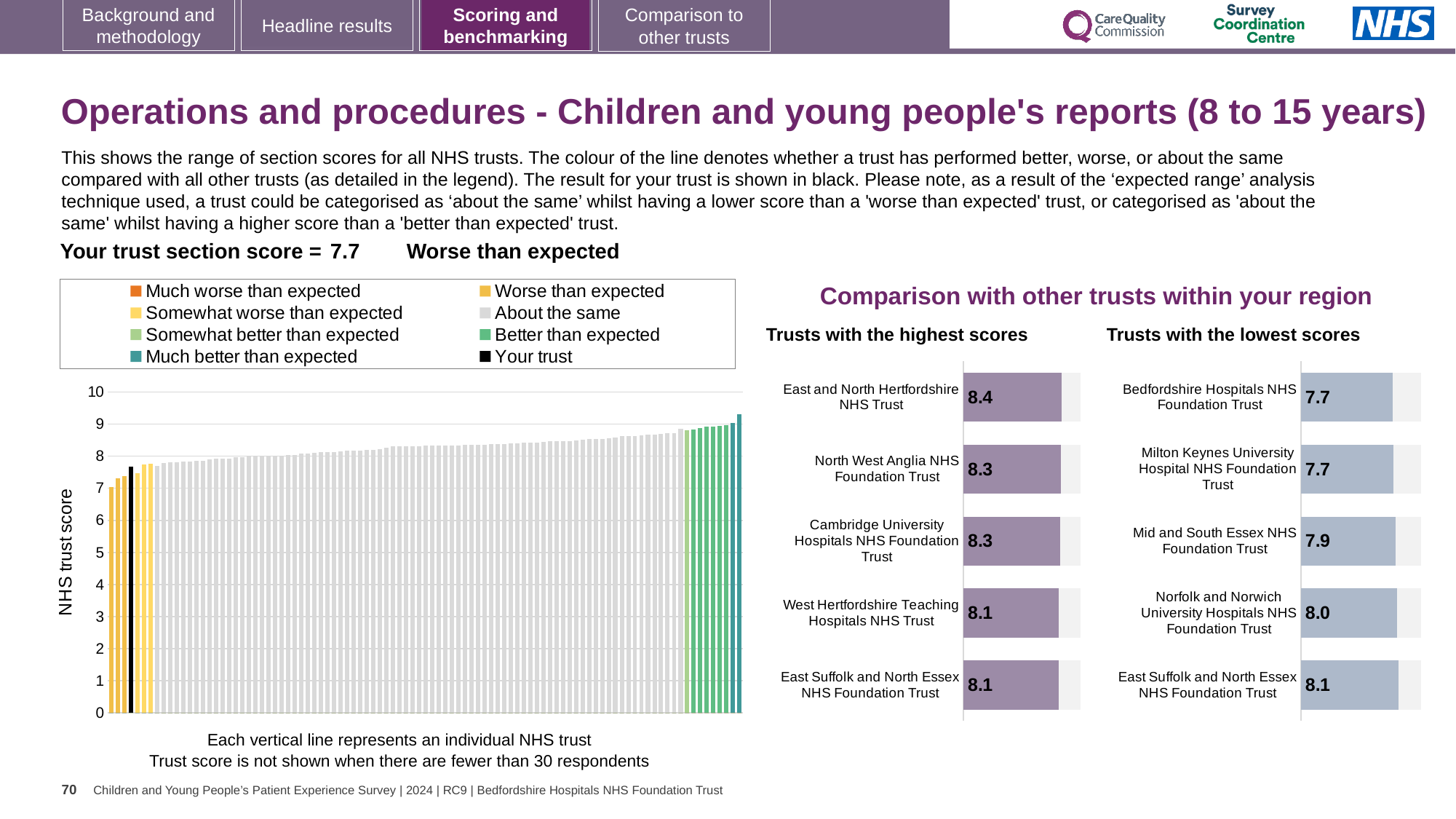
What kind of chart is the 'NHS trust score' chart on the left of the slide? Bar chart In the 'NHS trust score' chart on the left, do the bar values rise or fall from left to right? Rise In the 'Trusts with the highest scores' chart, what is the score for East and North Hertfordshire NHS Trust? 8.4 How many entries does the legend above the 'NHS trust score' chart list? 8 In the 'Trusts with the lowest scores' chart, what is the difference between the scores of Norfolk and Norwich University Hospitals NHS Foundation Trust and Bedfordshire Hospitals NHS Foundation Trust? 0.3 How many trusts are shown in the 'Trusts with the highest scores' chart? 5 In the 'Trusts with the lowest scores' chart, which has the larger score: Mid and South Essex NHS Foundation Trust or Milton Keynes University Hospital NHS Foundation Trust? Mid and South Essex NHS Foundation Trust In the 'Trusts with the lowest scores' chart, which trust has the highest score shown? East Suffolk and North Essex NHS Foundation Trust In the 'Trusts with the lowest scores' chart, what is the score for Mid and South Essex NHS Foundation Trust? 7.9 In the 'Trusts with the highest scores' chart, which trust has the highest score? East and North Hertfordshire NHS Trust In the 'Trusts with the highest scores' chart, what is the difference between the scores of East and North Hertfordshire NHS Trust and West Hertfordshire Teaching Hospitals NHS Trust? 0.3 In the 'NHS trust score' chart on the left, is the value for the black 'Your trust' bar greater or less than 8? less